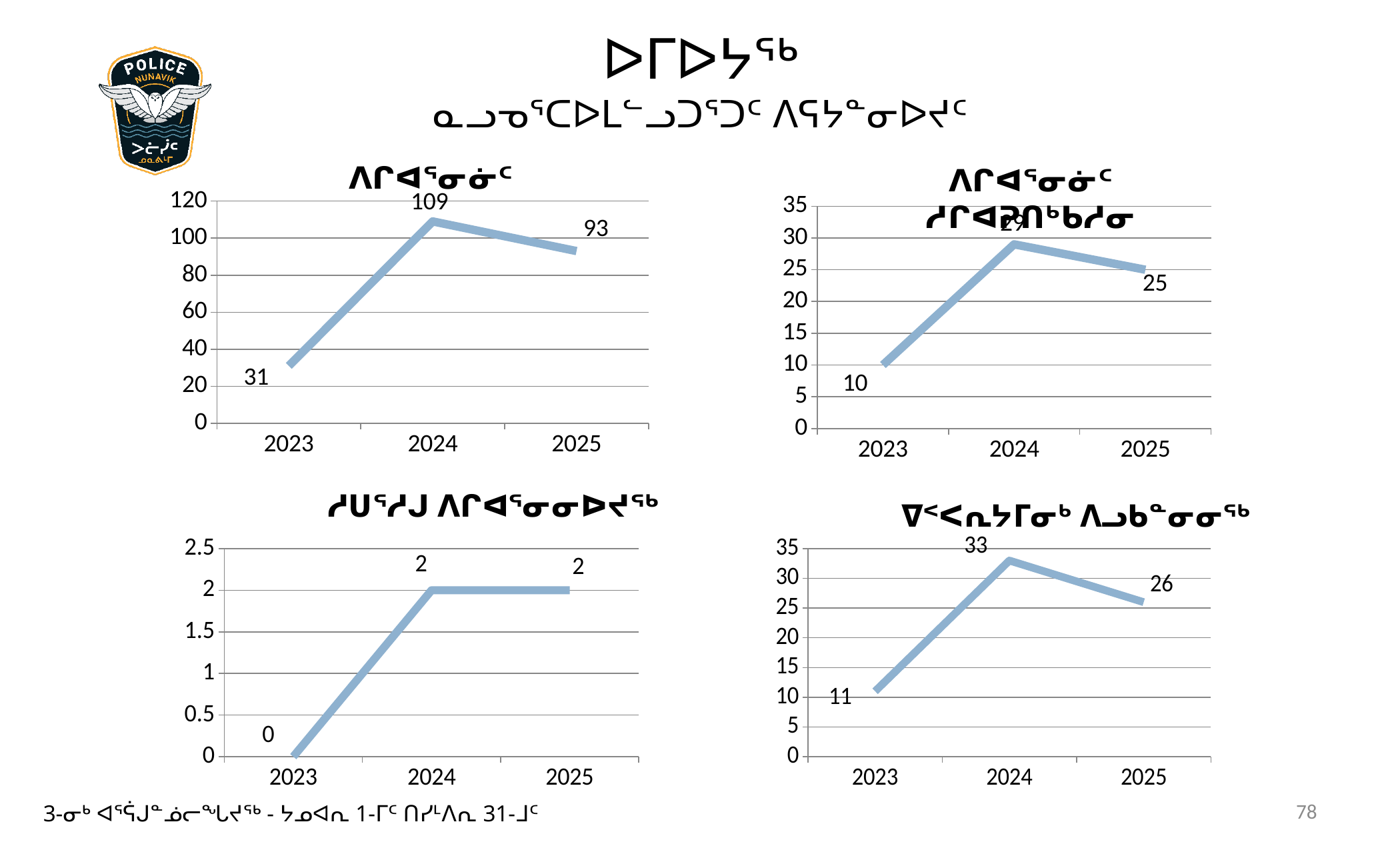
In the top-right chart, which year has the highest value? 2024 In the top-left chart, what is the value for 2024? 109 In the top-right chart, what is the value for 2025? 25 In the top-left chart, what is the difference between the 2024 and 2025 values? 16 In the bottom-left chart, how many years are plotted on the x axis? 3 In the top-left chart, which year has the lowest value? 2023 In the bottom-right chart, what is the value for 2024? 33 In the top-right chart, is the value for 2024 greater or less than 25? greater What kind of chart is the bottom-right chart? line chart In the top-left chart, what is the value for 2023? 31 In the bottom-left chart, what is the value for 2023? 0 In the bottom-right chart, which is larger, the value for 2023 or the value for 2025? 2025